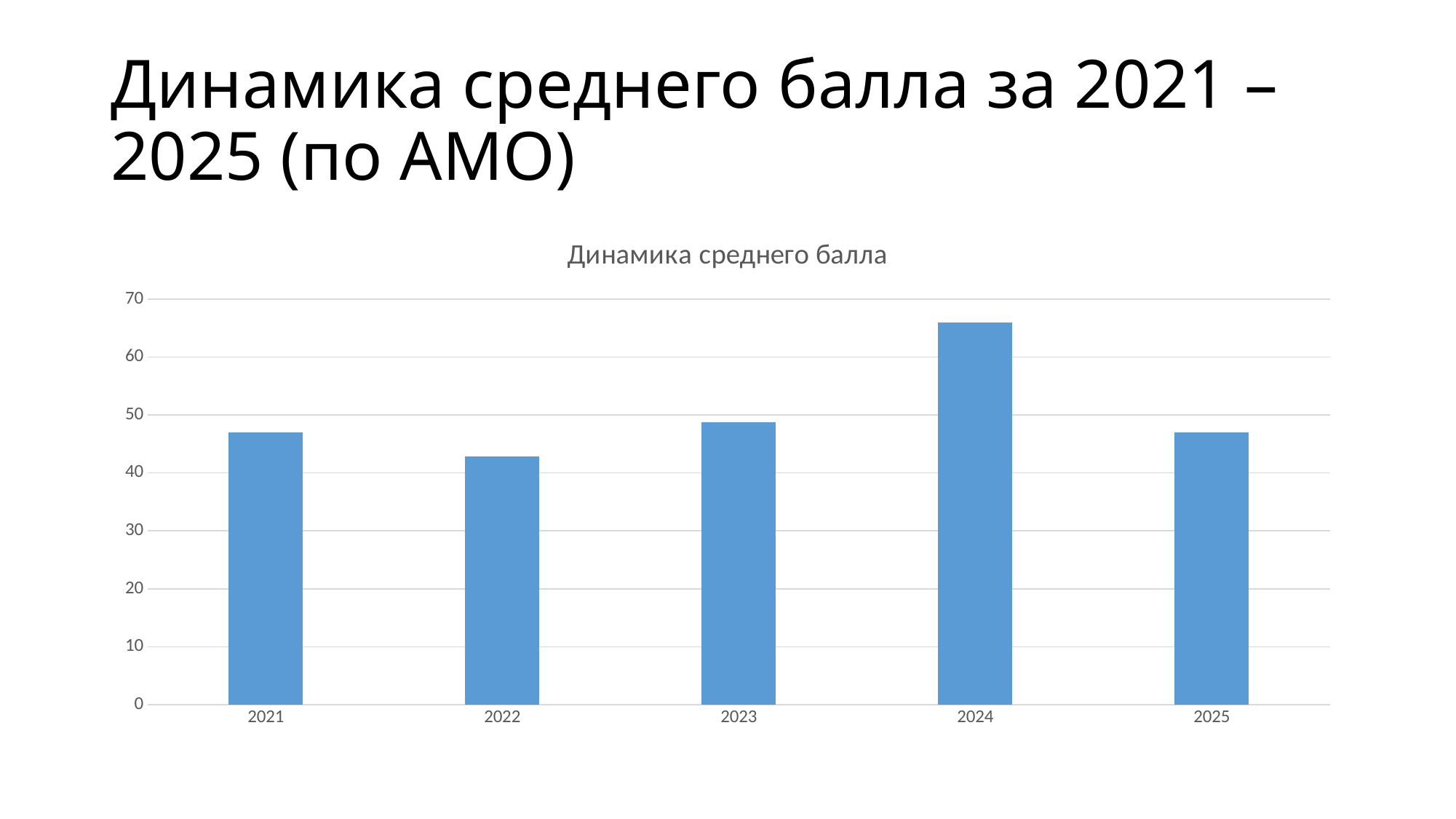
Which year has the highest value in the chart? 2024 What is the title of the chart? Динамика среднего балла Is the value for 2021 greater or less than 50? less Is the value for 2024 greater or less than 60? greater Which is larger, the value for 2021 or the value for 2022? 2021 Is the value for 2022 greater or less than 40? greater Which year has the lowest value in the chart? 2022 Which is larger, the value for 2023 or the value for 2024? 2024 How many years are shown on the x axis of the chart? 5 What kind of chart is shown on the slide? bar chart Does the value rise or fall from 2024 to 2025? fall